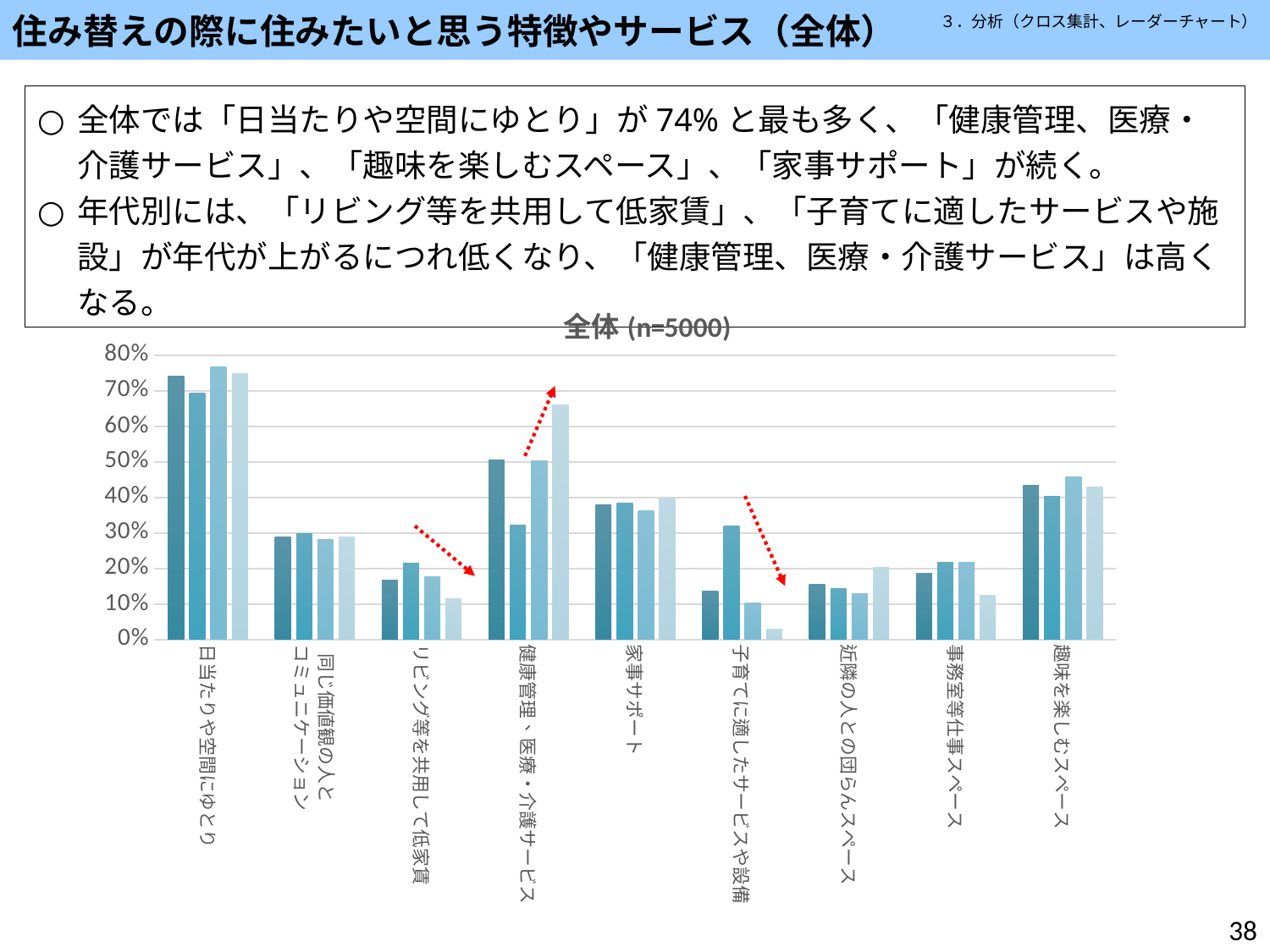
Are all four bars for 近隣の人との団らんスペース greater or less than 30%? less Which category contains the single lowest bar in the chart? 子育てに適したサービスや設備 Are all four bars for 家事サポート greater or less than 30%? greater How many bars are plotted for each category in the chart? 4 How many categories are shown on the x axis of the chart? 9 Is the lightest (rightmost) bar for 健康管理・医療・介護サービス greater or less than 60%? greater Which category has higher bars overall: 同じ価値観の人とコミュニケーション or 事務室等仕事スペース? 同じ価値観の人とコミュニケーション What kind of chart is shown on the slide? bar chart What is the title of the chart? 全体 (n=5000) For 子育てに適したサービスや設備, do the last three bars rise or fall from left to right? fall Which category has the highest bars in the chart? 日当たりや空間にゆとり